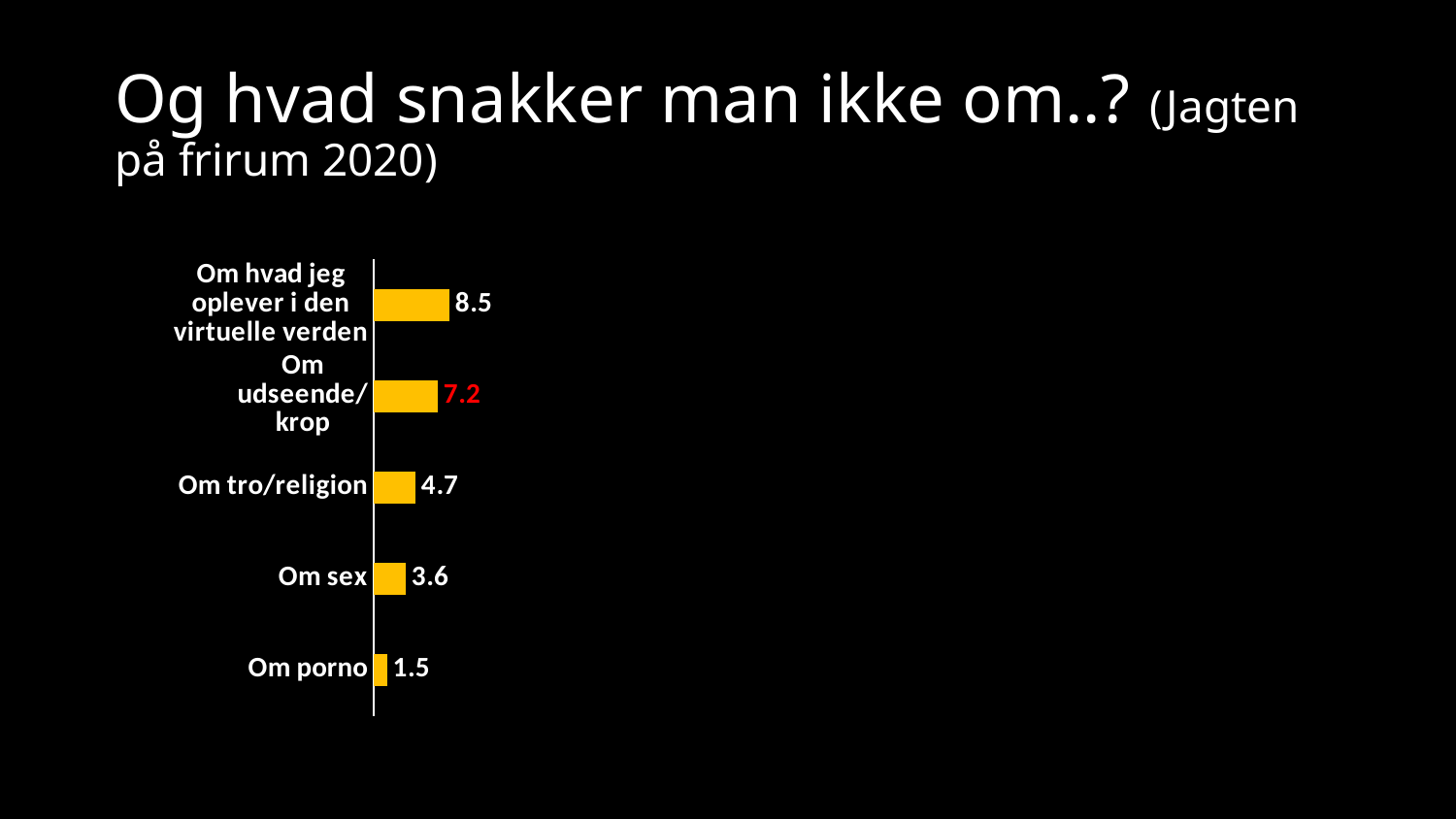
What is the difference between the values for "Om hvad jeg oplever i den virtuelle verden" and "Om udseende/krop"? 1.3 What is the value for "Om hvad jeg oplever i den virtuelle verden"? 8.5 What is the value for "Om porno"? 1.5 What is the value for "Om sex"? 3.6 What kind of chart is shown on the slide? Bar chart What is the value for "Om tro/religion"? 4.7 Which category has the highest value? Om hvad jeg oplever i den virtuelle verden Which category has the lowest value? Om porno Which is larger, the value for "Om tro/religion" or the value for "Om sex"? Om tro/religion What is the value for "Om udseende/krop"? 7.2 How many categories are shown in the chart? 5 Which data label is shown in red rather than white? 7.2